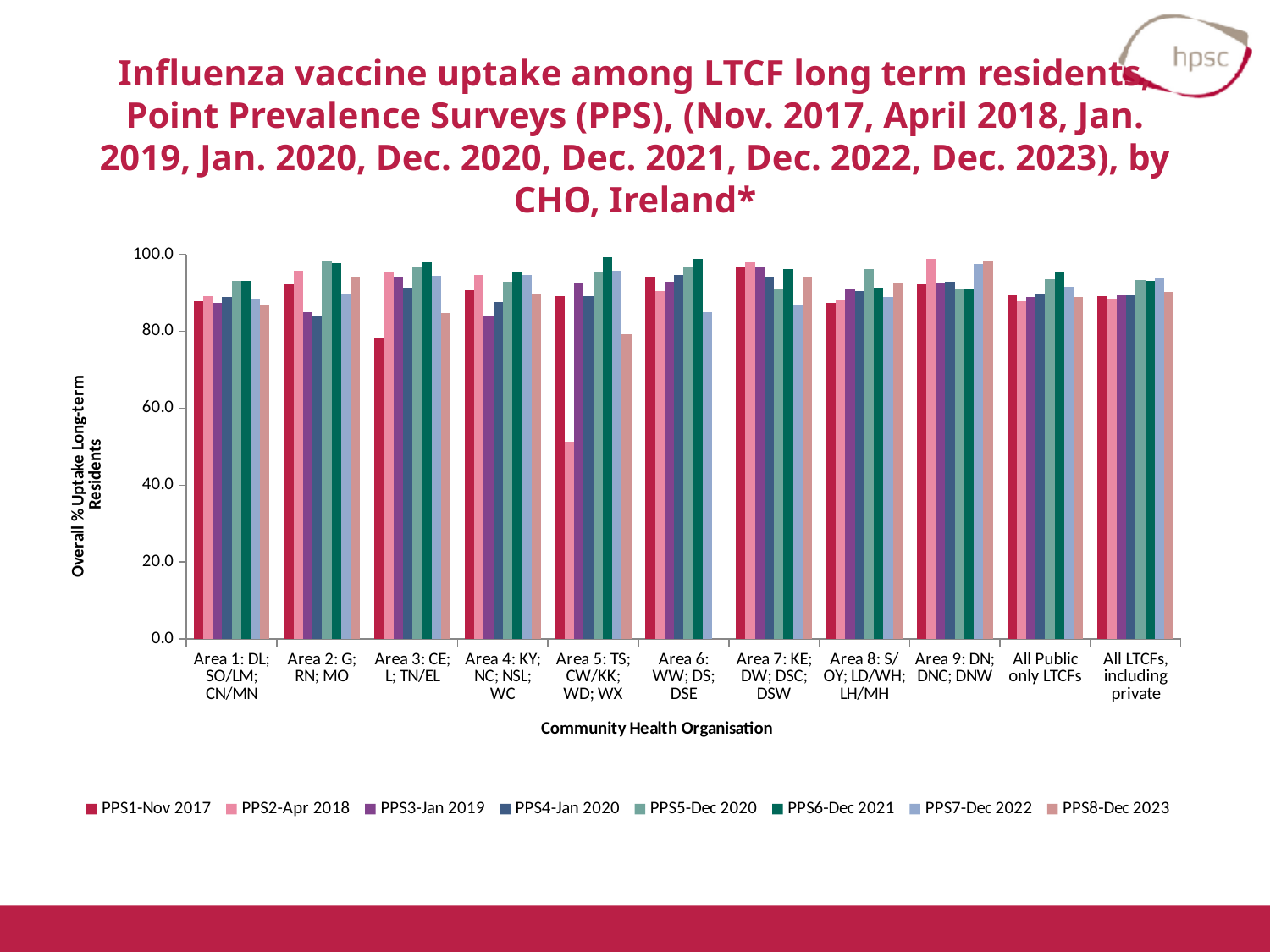
How many series does the legend list? 8 Is the value for PPS2-Apr 2018 in Area 5: TS; CW/KK; WD; WX greater or less than 40? greater What is the title of the y axis? Overall % Uptake Long-term Residents How many Community Health Organisation categories are shown on the x axis? 11 What is the title of the x axis? Community Health Organisation In Area 5: TS; CW/KK; WD; WX, which is larger: the value for PPS2-Apr 2018 or the value for PPS6-Dec 2021? PPS6-Dec 2021 Is the value for PPS7-Dec 2022 in Area 6: WW; DS; DSE greater or less than 80? greater Within Area 5: TS; CW/KK; WD; WX, which survey has the lowest uptake? PPS2-Apr 2018 Is the value for PPS2-Apr 2018 in Area 5: TS; CW/KK; WD; WX greater or less than 60? less What kind of chart is shown on the slide? bar chart